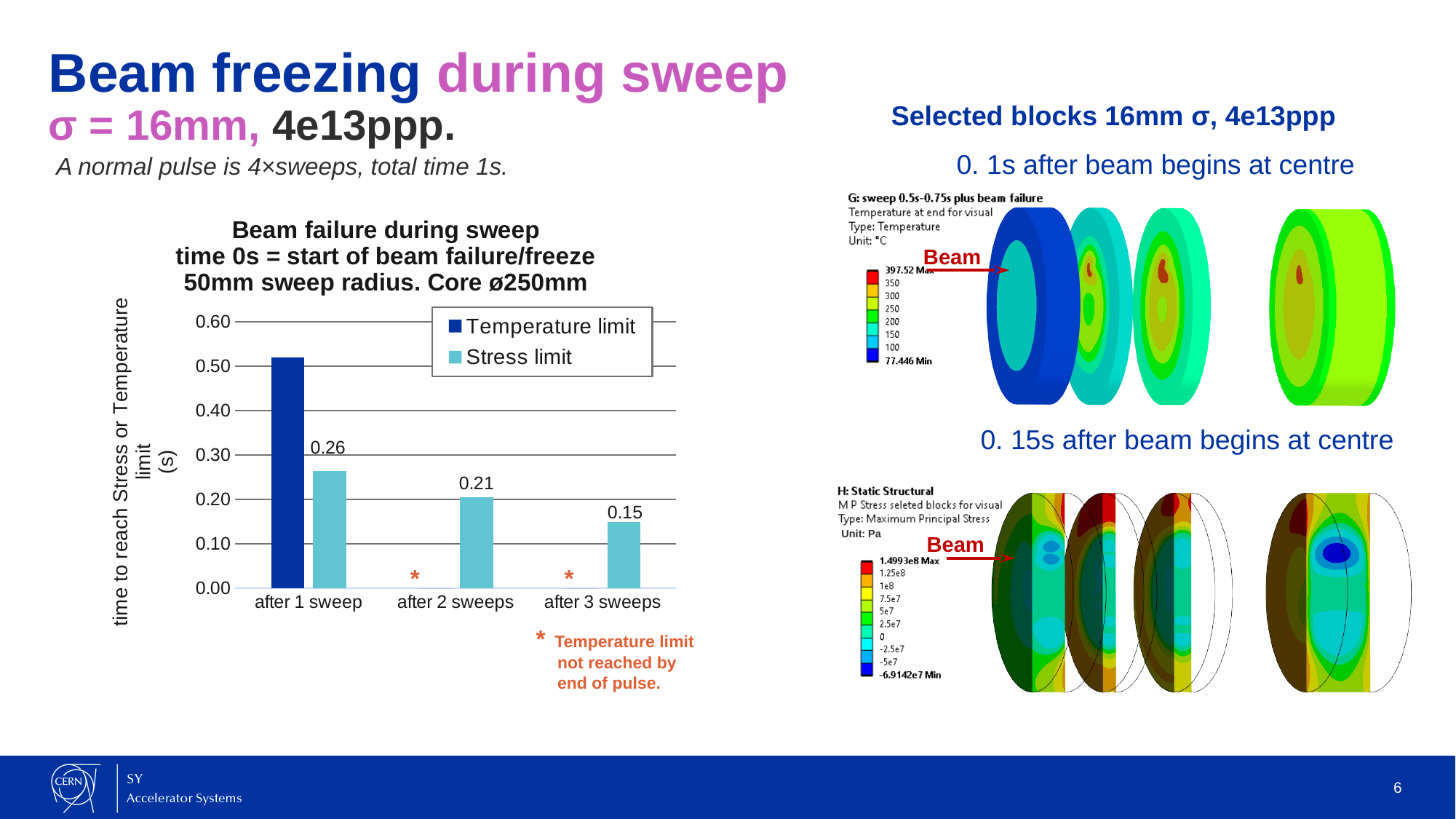
What kind of chart is shown? bar chart What is the Stress limit value after 3 sweeps? 0.15 How many series does the legend list? 2 What is the difference between the Stress limit values after 1 sweep and after 3 sweeps? 0.11 Which category has the lowest Stress limit value? after 3 sweeps How many categories are shown on the x axis? 3 After 1 sweep, which is larger: the Temperature limit or the Stress limit? Temperature limit What is the Stress limit value after 1 sweep? 0.26 Which category has the highest Stress limit value? after 1 sweep What is the Stress limit value after 2 sweeps? 0.21 Is the Temperature limit value after 1 sweep greater or less than 0.50? greater Do the Stress limit values rise or fall from after 1 sweep to after 3 sweeps? fall